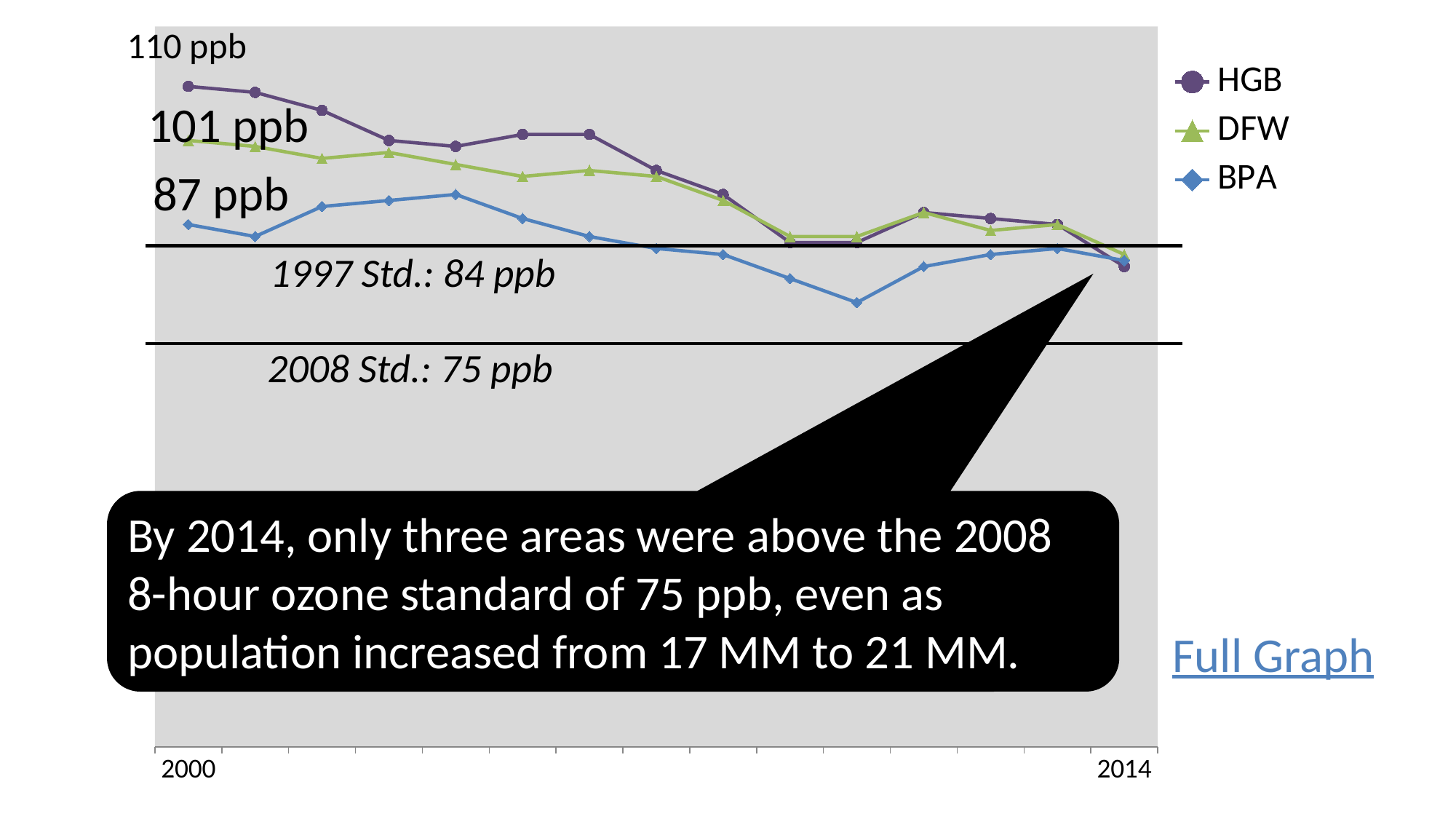
What is the BPA value in 2000? 87 ppb Is the HGB value in 2014 greater or less than 75 ppb? greater What is the difference between the HGB and DFW values in 2000? 9 ppb What kind of chart is shown on the slide? line chart How many series does the legend list? 3 What is the HGB value in 2000? 110 ppb What value is the 2008 standard reference line labelled with? 75 ppb Do the HGB values generally rise or fall from 2000 to 2014? fall Which series has the highest value in 2000? HGB What is the difference between the HGB and BPA values in 2000? 23 ppb What is the DFW value in 2000? 101 ppb Which series has the lowest value in 2000? BPA